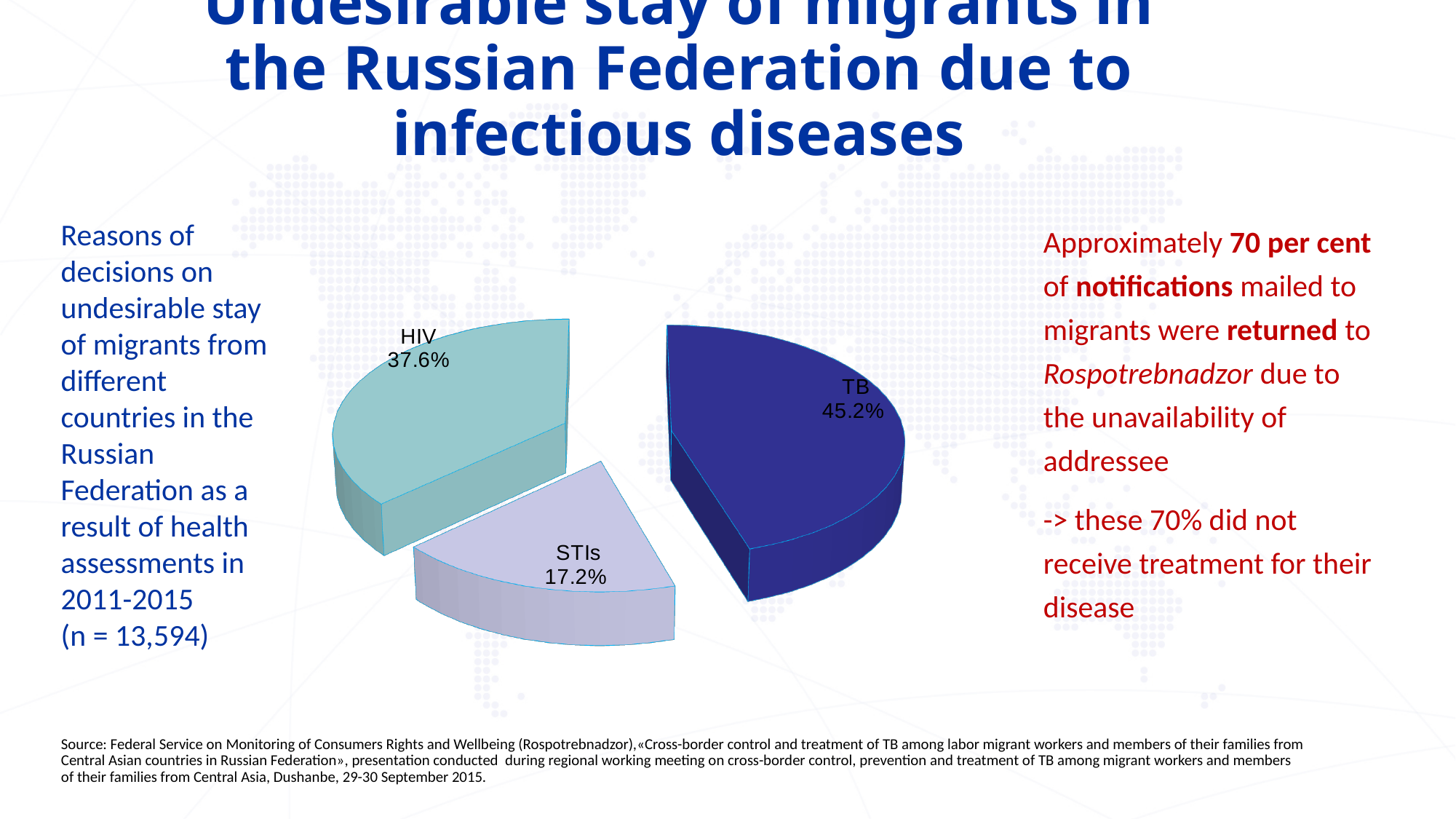
How many slices does the pie chart have? 3 What percentage of the pie chart is labelled STIs? 17.2% What kind of chart is shown on the slide? pie chart What colour is the TB slice of the pie chart? dark blue What is the difference in percentage points between the HIV slice and the STIs slice? 20.4 What percentage of the pie chart is labelled HIV? 37.6% Which disease has the smallest slice of the pie chart? STIs What is the difference in percentage points between the TB slice and the HIV slice? 7.6 What percentage of the pie chart is labelled TB? 45.2% Which disease has the largest slice of the pie chart? TB Which slice is larger, HIV or STIs? HIV Which slice is larger, TB or HIV? TB